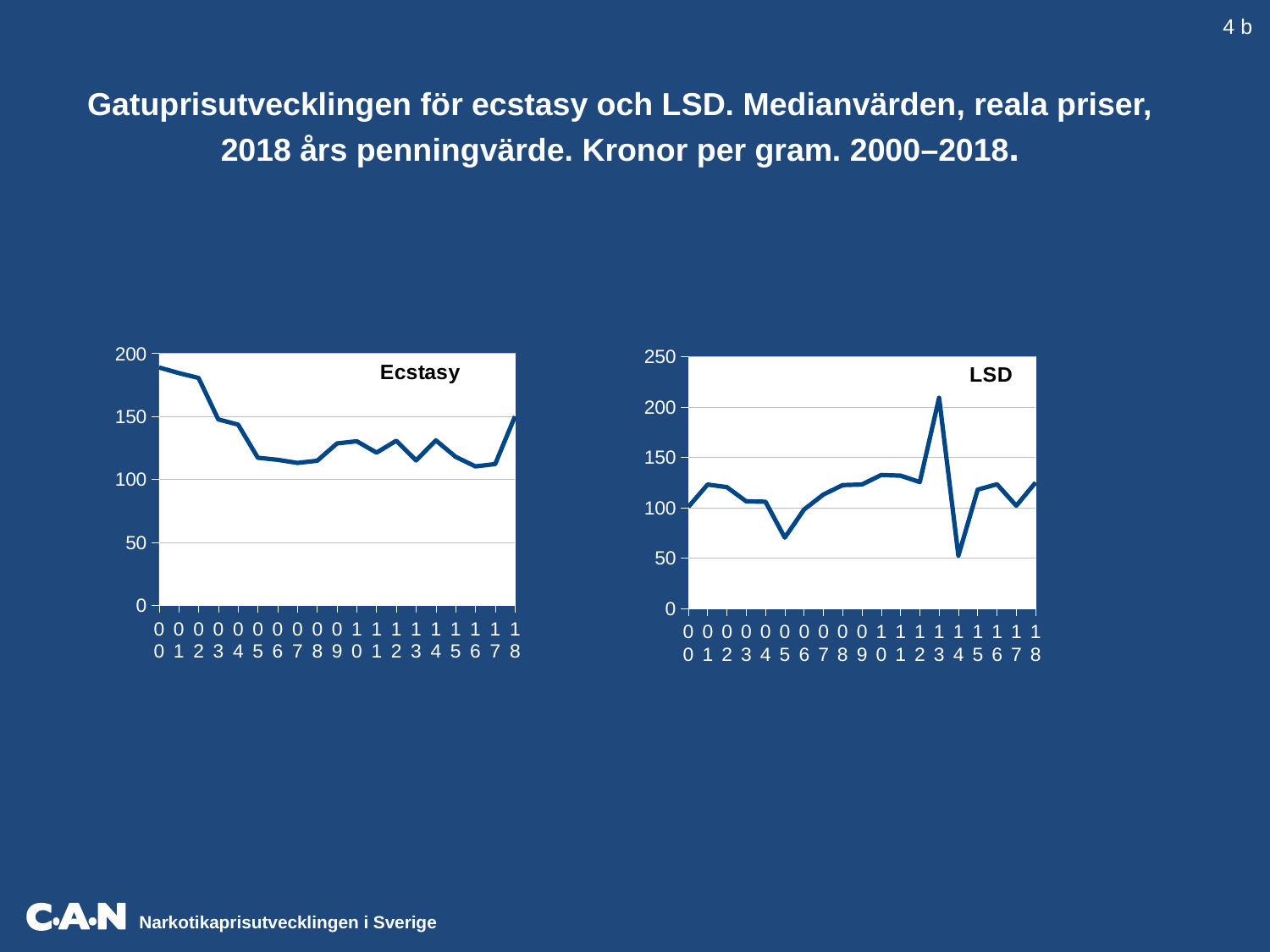
In the Ecstasy chart, does the value rise or fall from 2000 to 2005? fall In the LSD chart, which year has the lowest value? 2014 In the Ecstasy chart, which year has the highest value? 2000 In the LSD chart, how many years are plotted along the x axis? 19 In the LSD chart, which year has the larger value, 2013 or 2014? 2013 What kind of chart is the Ecstasy chart on the left? line chart In the LSD chart, which year has the highest value? 2013 In the LSD chart, is the value for 2005 greater or less than 100? less In the Ecstasy chart, how many years are plotted along the x axis? 19 In the Ecstasy chart, is the value for 2005 greater or less than 150? less What kind of chart is the LSD chart on the right? line chart In the Ecstasy chart, is the value for 2000 greater or less than 150? greater